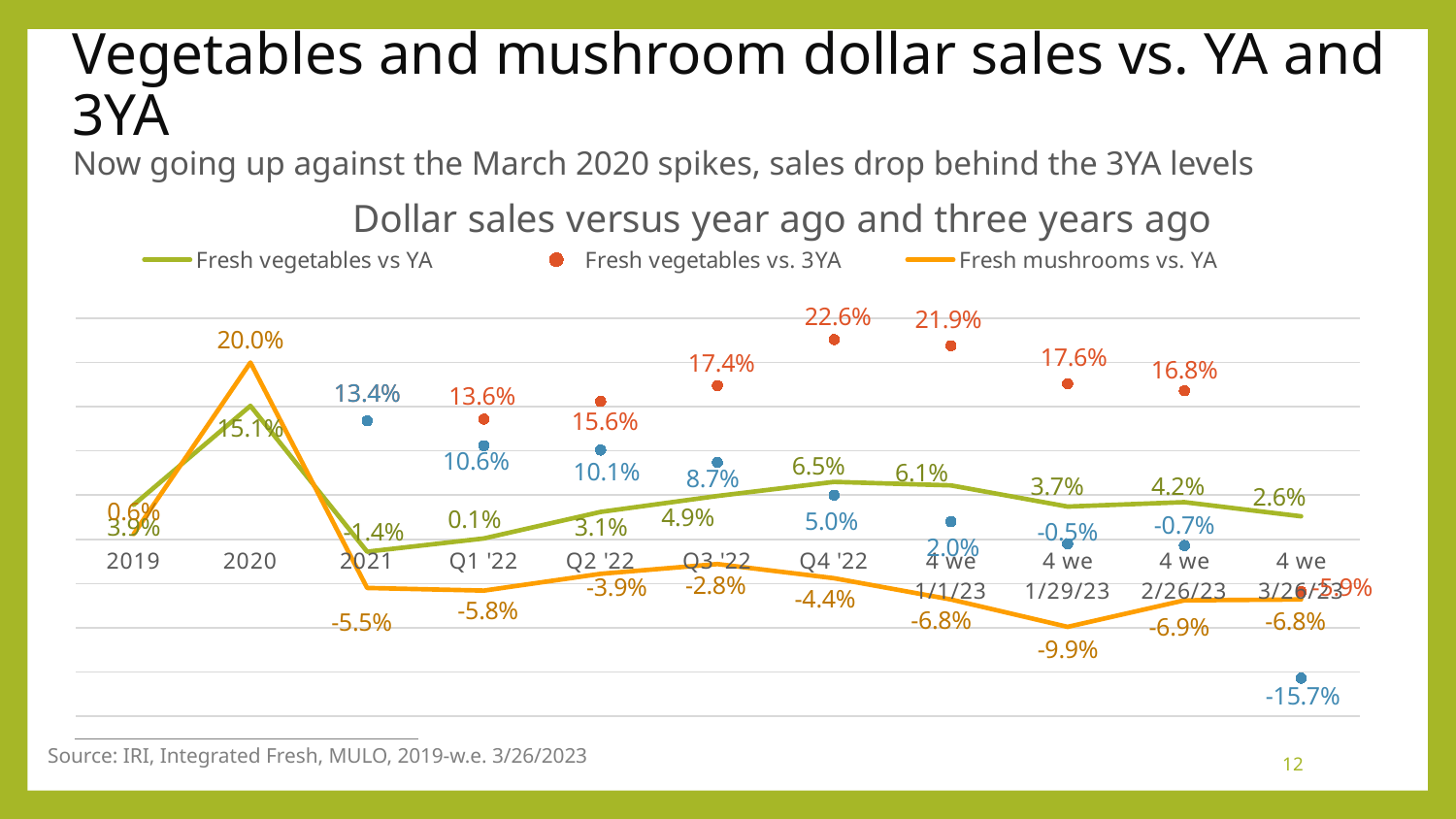
In which period is Fresh vegetables vs YA highest? 2020 What kind of chart is shown on the slide? Line chart How many periods are shown on the x axis? 11 In Q1 '22, which is larger: Fresh vegetables vs YA or Fresh mushrooms vs. YA? Fresh vegetables vs YA How many series does the chart legend list? 3 In which period is Fresh mushrooms vs. YA lowest? 4 we 1/29/23 What is the value for Fresh mushrooms vs. YA in Q3 '22? -2.8% What is the value for Fresh vegetables vs YA in 2021? -1.4% What is the title of the chart? Dollar sales versus year ago and three years ago What is the difference between Fresh mushrooms vs. YA and Fresh vegetables vs YA in 2020? 4.9 percentage points What is the value for Fresh mushrooms vs. YA in 2020? 20.0% What is the value for Fresh vegetables vs YA in Q4 '22? 6.5%